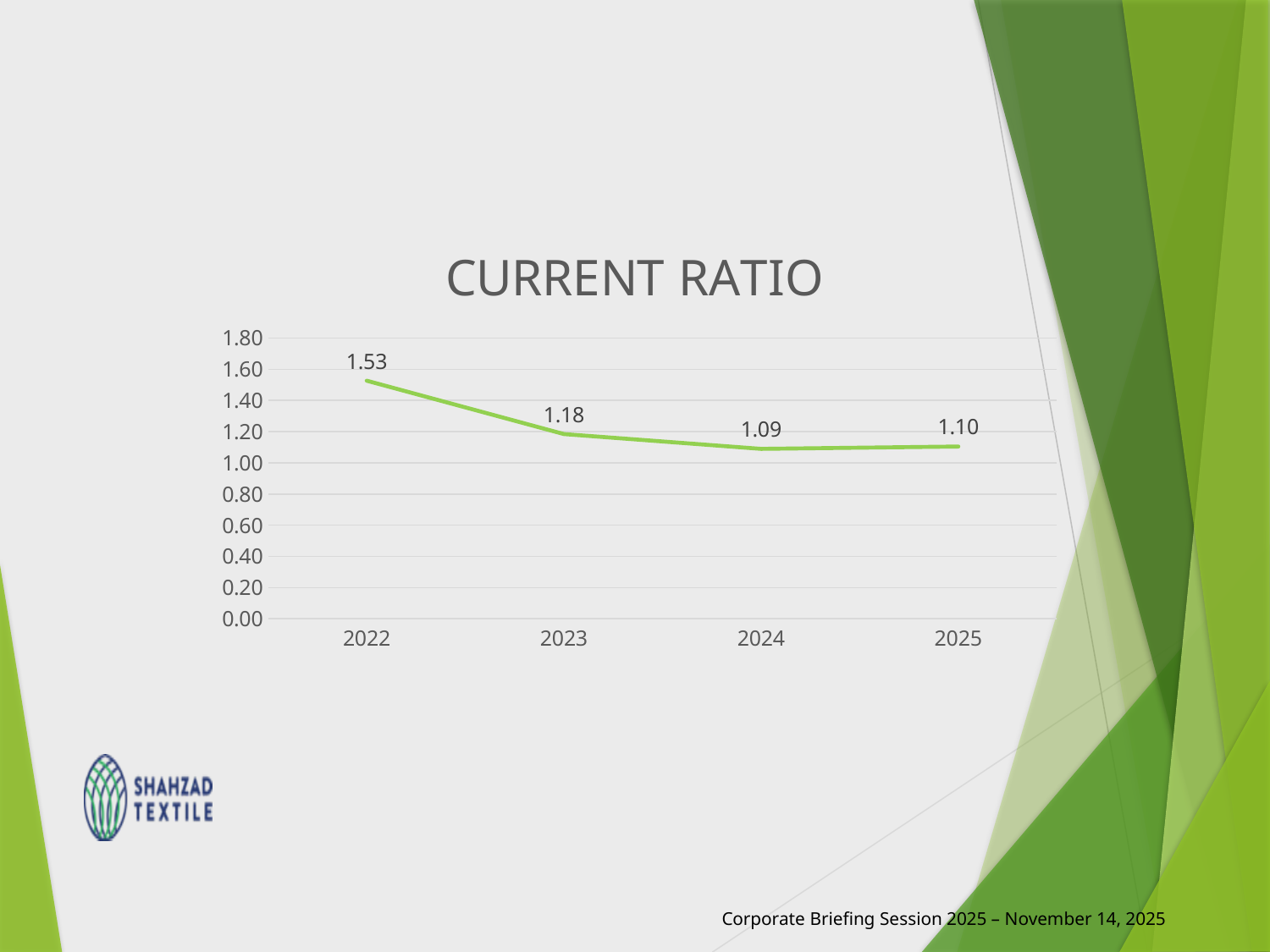
Which year has the lowest current ratio? 2024 What is the current ratio for 2025? 1.10 What is the current ratio for 2024? 1.09 Which year has the highest current ratio? 2022 Which year has a higher current ratio, 2023 or 2025? 2023 What kind of chart is shown on the slide? line chart How many years are plotted on the chart? 4 Does the current ratio rise or fall from 2022 to 2024? fall What is the current ratio for 2022? 1.53 Is the current ratio for 2022 greater or less than 1.40? greater What is the title of the chart? CURRENT RATIO What is the difference between the current ratio in 2022 and in 2023? 0.35